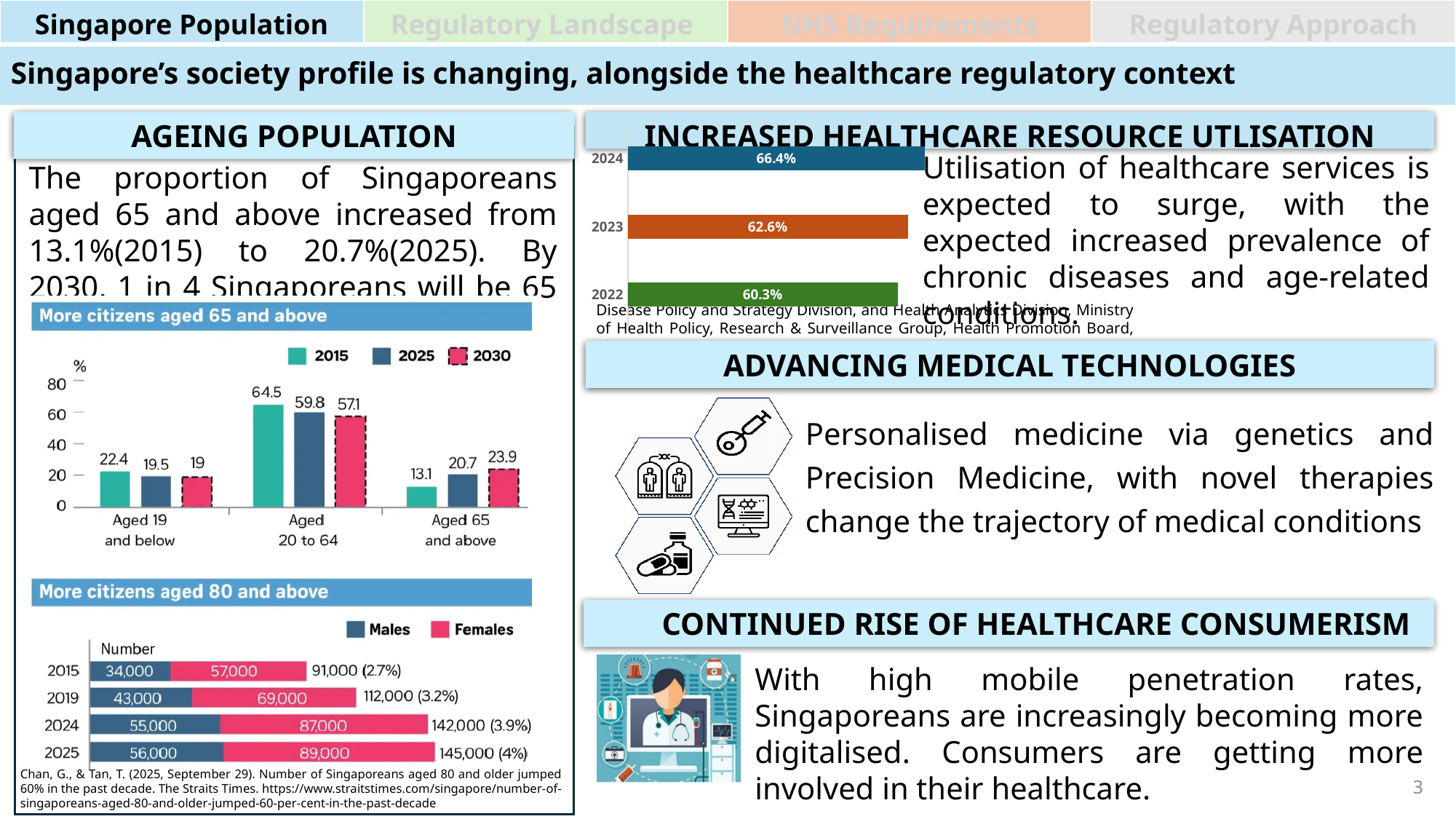
In the 'More citizens aged 80 and above' chart, what kind of chart is it? stacked bar chart In the 'More citizens aged 65 and above' chart, do the values for Aged 19 and below rise or fall from 2015 to 2030? fall In the chart under 'Increased Healthcare Resource Utilisation', how many years are shown? 3 In the 'More citizens aged 65 and above' chart, what is the value for Aged 65 and above in 2025? 20.7 In the chart under 'Increased Healthcare Resource Utilisation', what is the value for 2023? 62.6% In the chart under 'Increased Healthcare Resource Utilisation', which year has the highest value? 2024 In the 'More citizens aged 80 and above' chart, what is the total for 2019? 112,000 In the 'More citizens aged 65 and above' chart, what is the value for Aged 20 to 64 in 2015? 64.5 In the 'More citizens aged 80 and above' chart, which year has the lowest total? 2015 In the 'More citizens aged 65 and above' chart, what is the difference between the 2030 and 2015 values for Aged 65 and above? 10.8 In the 'More citizens aged 80 and above' chart, what is the number of Females in 2024? 87,000 In the 'More citizens aged 65 and above' chart, how many series does the legend list? 3